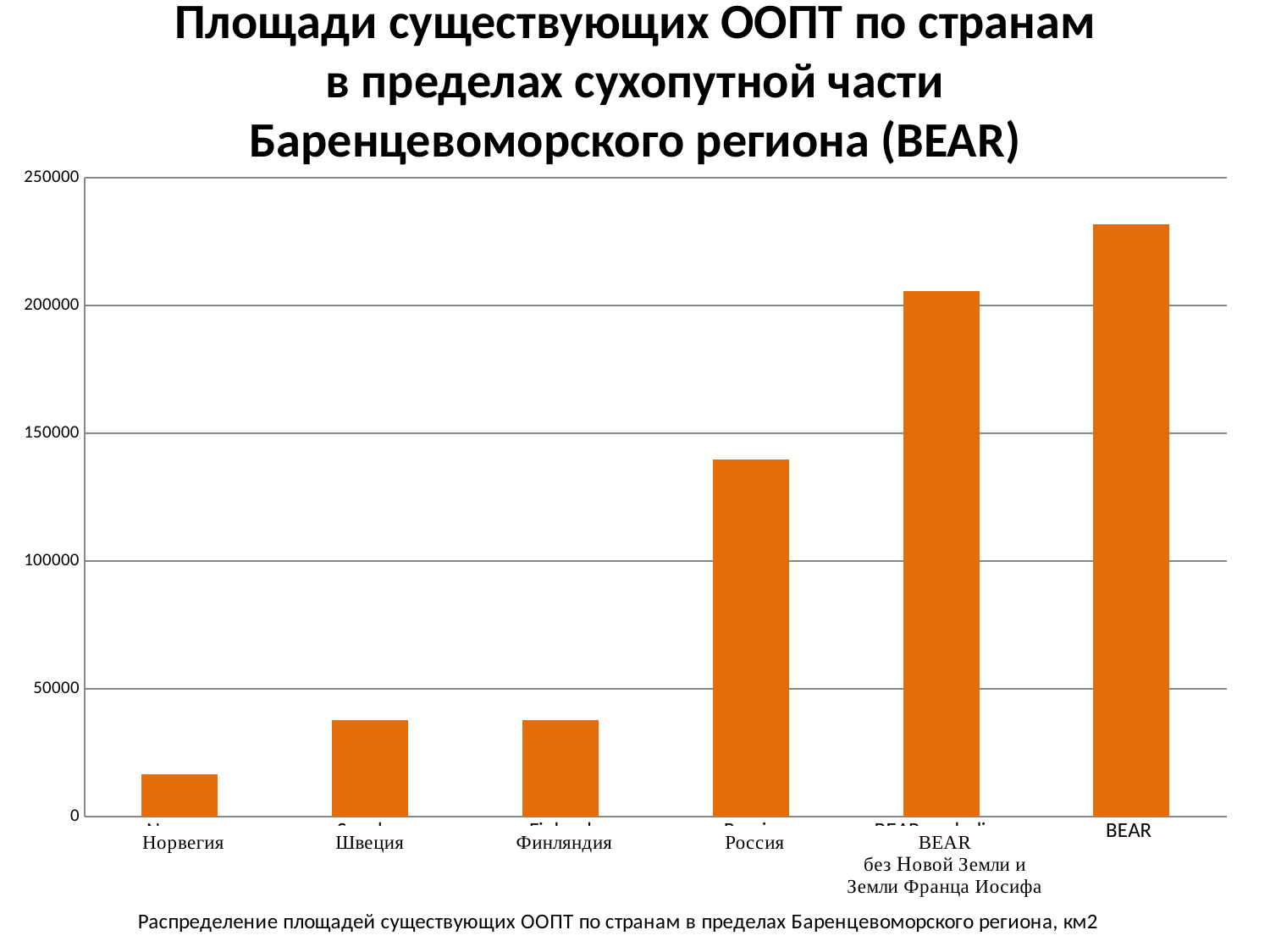
Which category has the highest value? BEAR Is the value for BEAR без Новой Земли и Земли Франца Иосифа greater or less than 150000? greater How many categories are plotted on the x axis? 6 What kind of chart is shown on the slide? bar chart Which category has the lowest value? Норвегия What colour are the bars in the chart? orange Which is larger, the value for BEAR or the value for BEAR без Новой Земли и Земли Франца Иосифа? BEAR Is the value for Норвегия greater or less than 50000? less Is the value for BEAR greater or less than 200000? greater Which is larger, the value for Россия or the value for Швеция? Россия